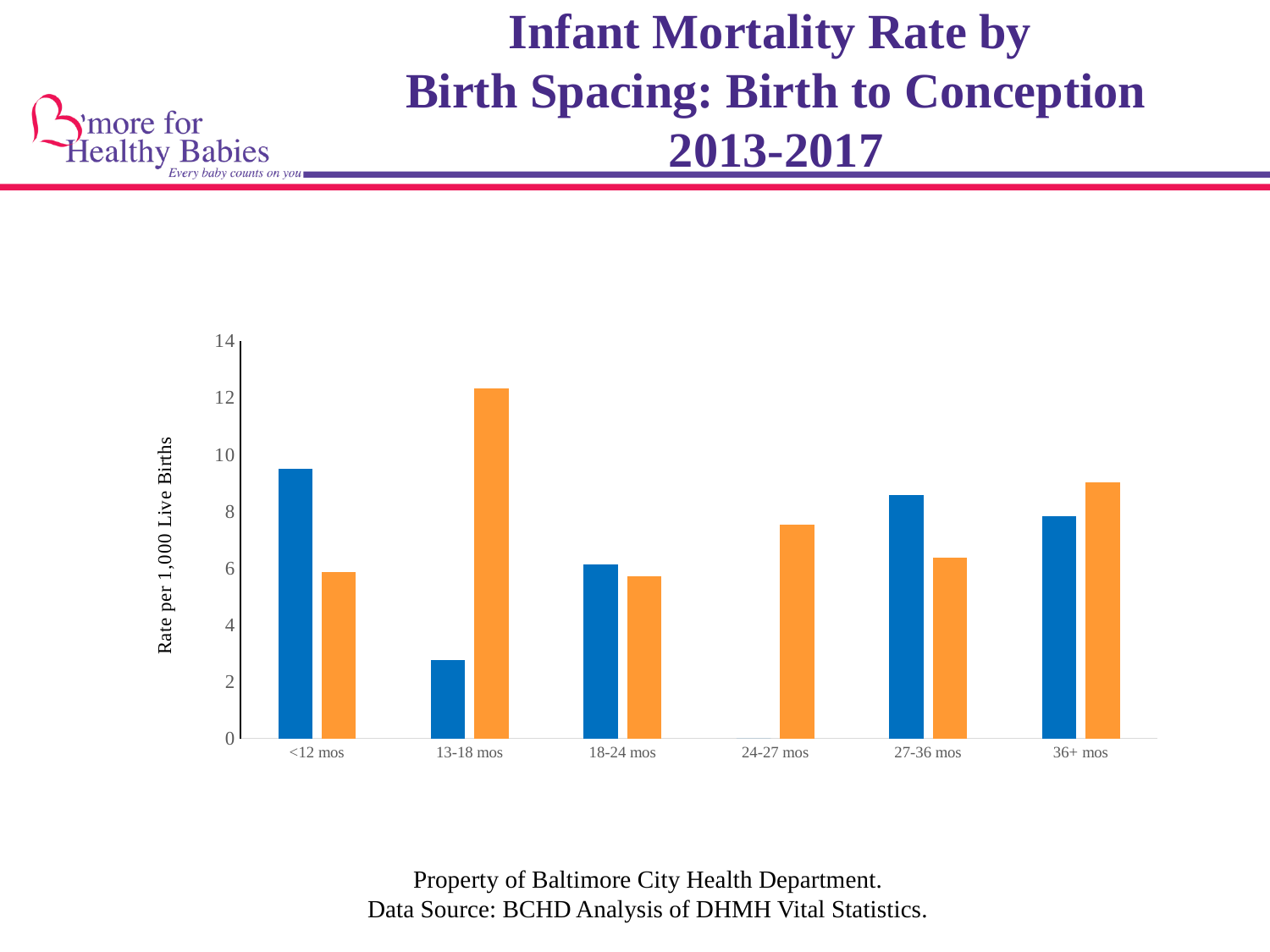
For the 36+ mos category, which bar is taller, the blue or the orange? orange How many birth spacing categories are shown on the x axis? 6 Which category has the highest orange bar? 13-18 mos Which category has the highest blue bar? <12 mos Is the blue bar for <12 mos greater or less than 8? greater What is the title of the chart on the slide? Infant Mortality Rate by Birth Spacing: Birth to Conception 2013-2017 Is the orange bar for 13-18 mos greater or less than 12? greater Is the blue bar for 13-18 mos greater or less than 4? less What kind of chart is shown on the slide? bar chart For the <12 mos category, which bar is taller, the blue or the orange? blue What is the y-axis label of the chart? Rate per 1,000 Live Births